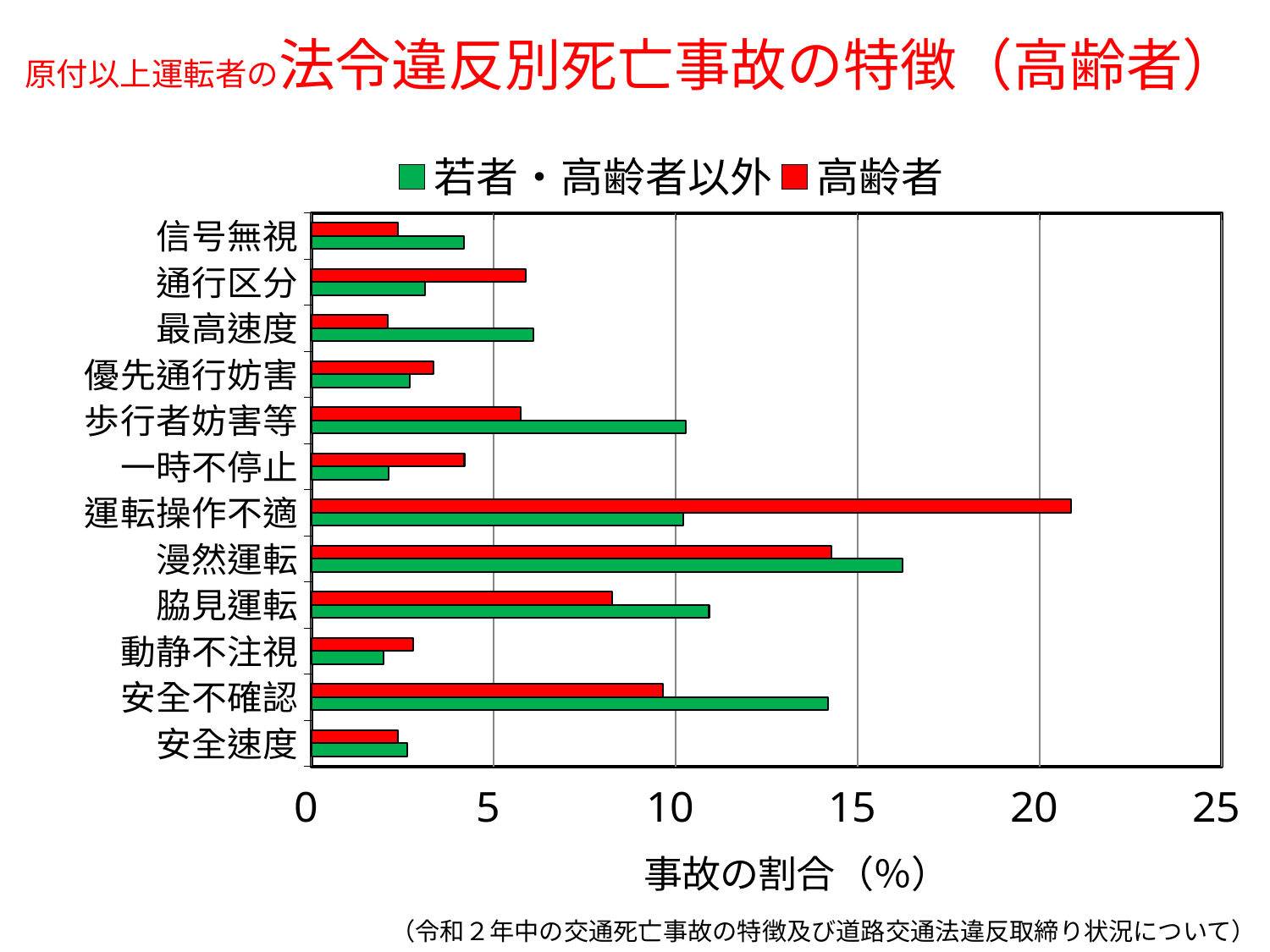
For 安全不確認, which series has the larger value, 高齢者 or 若者・高齢者以外? 若者・高齢者以外 What colour are the bars for the 高齢者 series? red For 運転操作不適, which series has the larger value, 高齢者 or 若者・高齢者以外? 高齢者 Is the 高齢者 value for 脇見運転 greater or less than 10? less Is the 若者・高齢者以外 value for 安全不確認 greater or less than 10? greater Which category has the highest value for 高齢者? 運転操作不適 What kind of chart is shown on the slide? bar chart Which category has the highest value for 若者・高齢者以外? 漫然運転 How many series does the legend list? 2 Is the 高齢者 value for 運転操作不適 greater or less than 20? greater How many violation categories are plotted on the y axis? 12